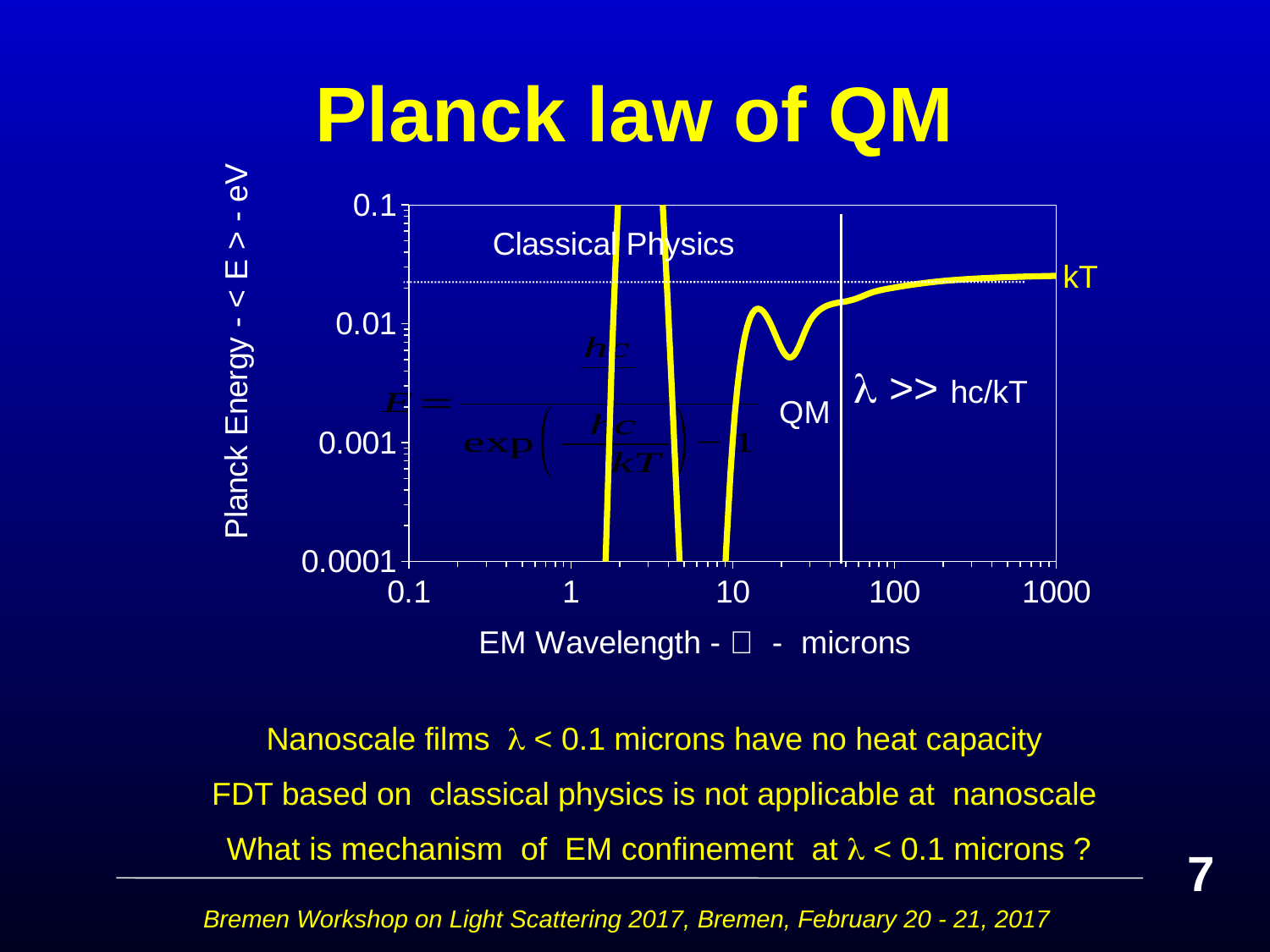
Does the Planck energy curve rise or fall as the wavelength increases from 100 to 1000 microns? rise How many labelled tick values are shown on the x axis of the chart? 5 What is the title of the chart on the slide? Planck law of QM What is the lowest value labelled on the y axis of the chart? 0.0001 What is the label of the x axis of the chart? EM Wavelength - λ - microns What kind of chart is shown on the slide? line chart What is the largest wavelength value labelled on the x axis of the chart? 1000 What label is written next to the horizontal dotted line that the curve approaches at large wavelengths? kT Is the Planck energy at a wavelength of 1000 microns greater or less than 0.01? greater Is the Planck energy at a wavelength of 100 microns greater or less than 0.01? greater What is the highest value labelled on the y axis of the chart? 0.1